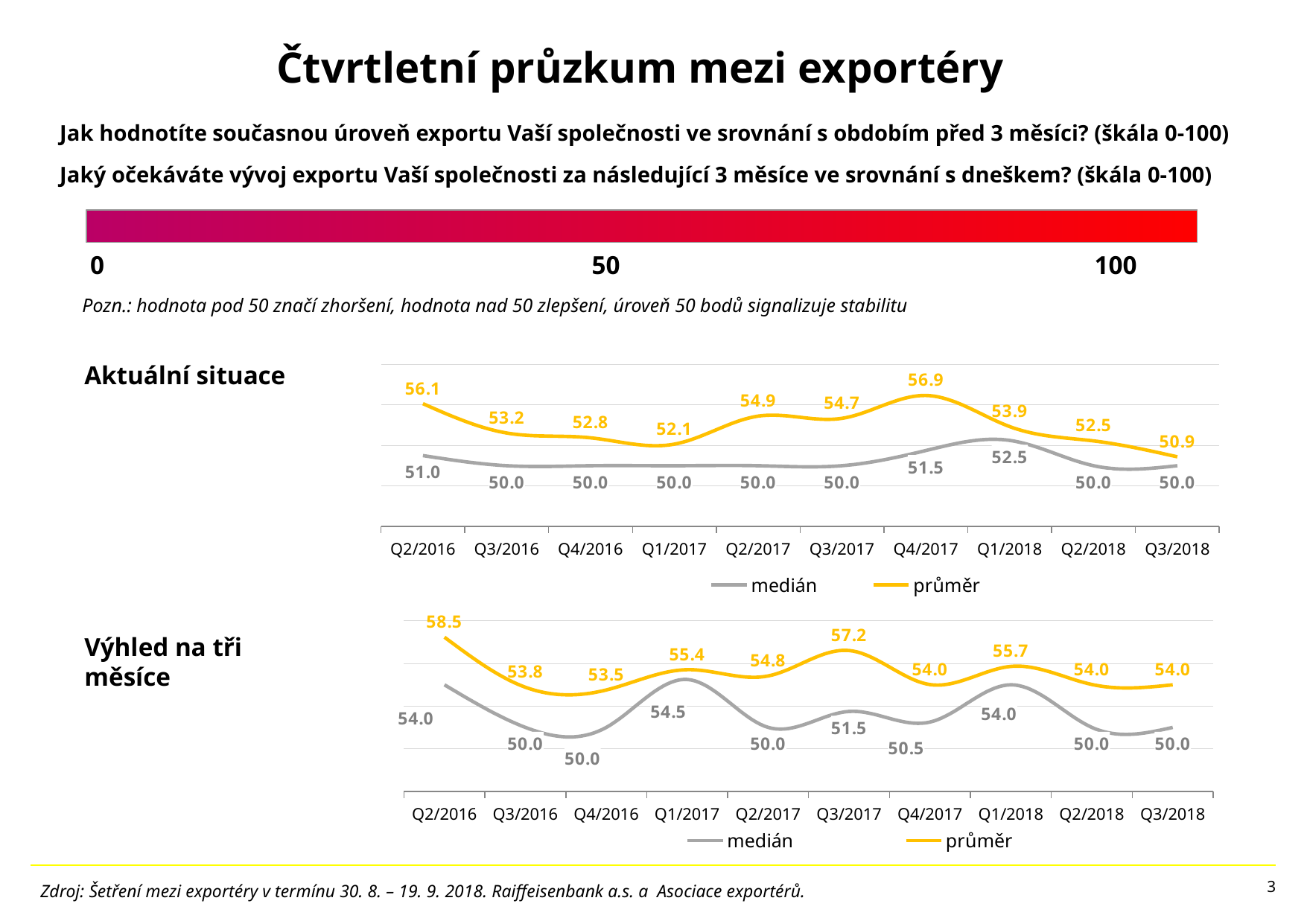
How many quarters are plotted on the x axis of the 'Aktuální situace' chart? 10 What kind of chart is the 'Aktuální situace' chart? Line chart How many series does the legend of the 'Výhled na tři měsíce' chart list? 2 In the 'Aktuální situace' chart, what is the průměr value for Q4/2017? 56.9 In the 'Aktuální situace' chart, which quarter has the lowest průměr value? Q3/2018 In the 'Výhled na tři měsíce' chart, what is the medián value for Q1/2017? 54.5 In the 'Aktuální situace' chart, what is the difference between the průměr values for Q2/2016 and Q3/2018? 5.2 In the 'Aktuální situace' chart, which quarter has the highest průměr value? Q4/2017 In the 'Aktuální situace' chart, what is the medián value for Q1/2018? 52.5 In the 'Výhled na tři měsíce' chart, which is larger, the průměr value for Q1/2018 or for Q2/2018? Q1/2018 In the 'Výhled na tři měsíce' chart, what is the průměr value for Q3/2017? 57.2 In the 'Výhled na tři měsíce' chart, which quarter has the highest průměr value? Q2/2016